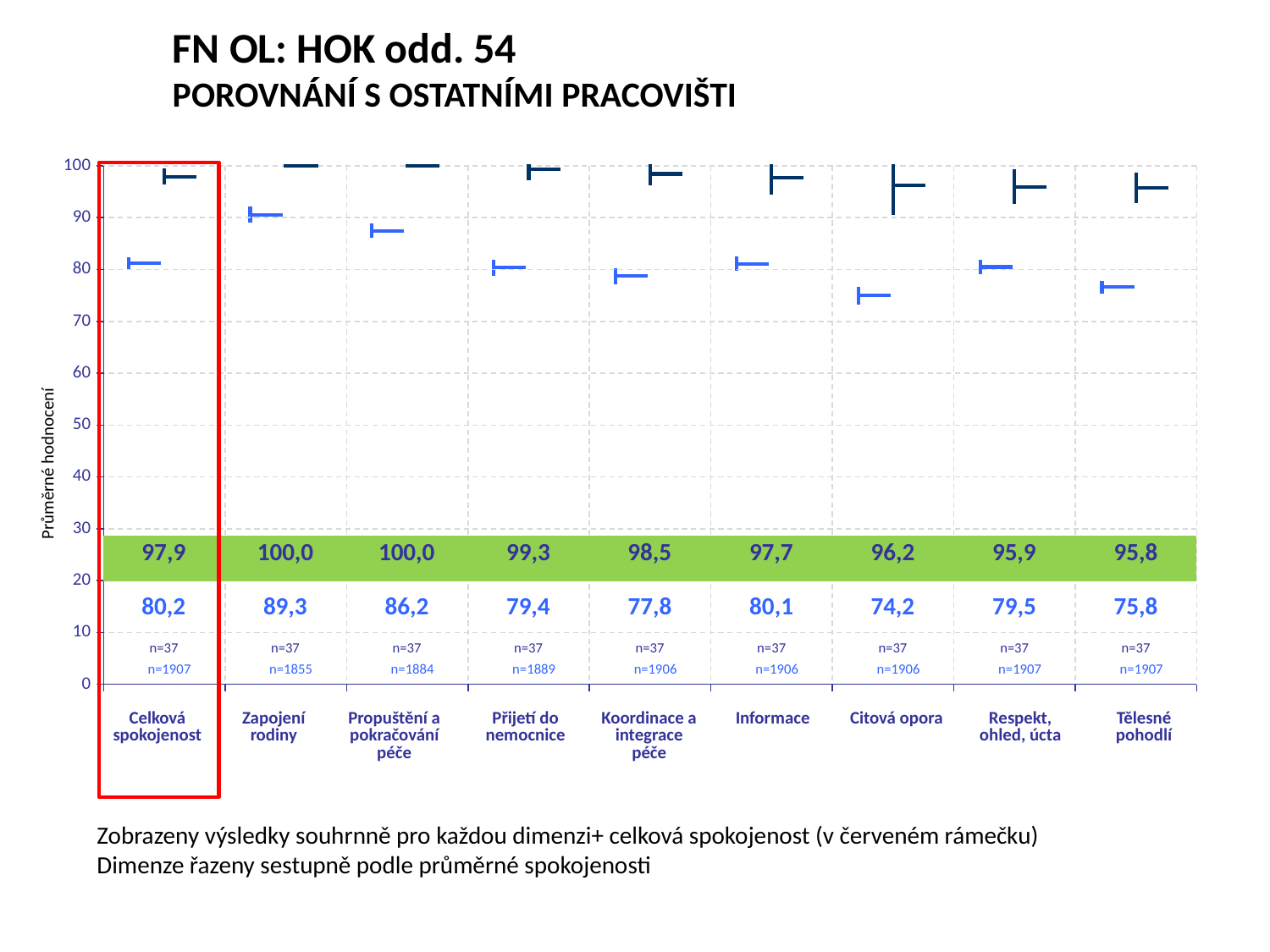
Which category has the lowest value in the green band row? Tělesné pohodlí What is the label of the y axis? Průměrné hodnocení Is the light blue marker for Citová opora greater or less than 80? less What is the value shown in the green band for Celková spokojenost? 97,9 What is the difference between the green band value and the blue row value for Celková spokojenost? 17,7 What is the blue (lower row) value shown for Zapojení rodiny? 89,3 Which category has the highest value in the blue lower row? Zapojení rodiny What is the second n value (lower) shown under Zapojení rodiny? n=1855 In the blue lower row, which is larger: Informace or Respekt, ohled, úcta? Informace How many categories are shown along the x axis? 9 Which category has the lowest value in the blue lower row? Citová opora What is the difference between the green band value and the blue row value for Citová opora? 22,0